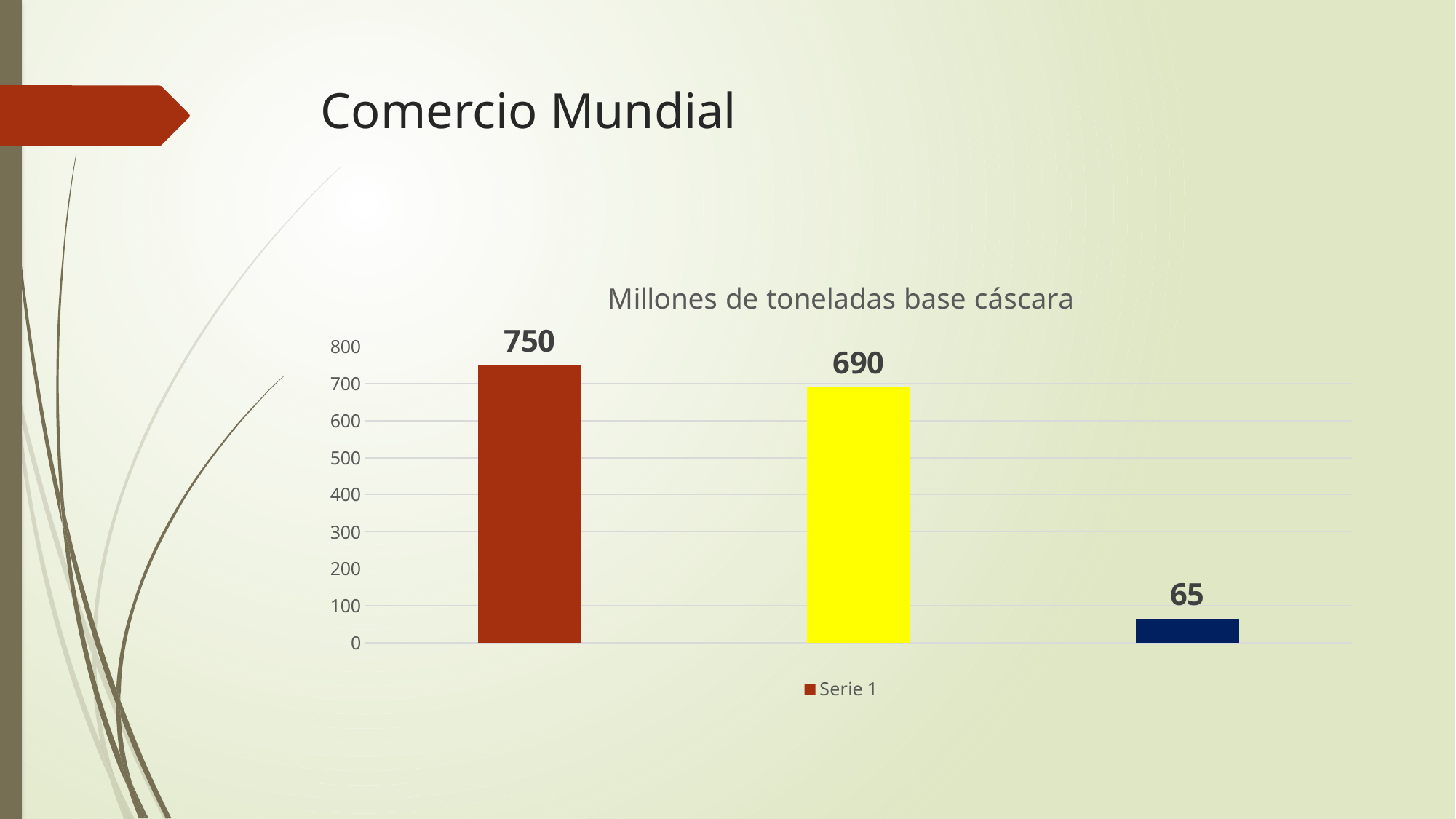
What is the title of the chart? Millones de toneladas base cáscara What is the difference between the red bar and the yellow bar? 60 How many series does the legend list? 1 What is the value of the red bar (first bar) in the chart? 750 What is the difference between the yellow bar and the dark blue bar? 625 Which bar has the lowest value in the chart? The dark blue bar (third bar), 65 Which bar has the highest value in the chart? The red bar (first bar), 750 How many bars are plotted in the chart? 3 Which is larger, the red bar or the yellow bar? The red bar What is the value of the yellow bar (second bar) in the chart? 690 What kind of chart is shown on the slide? Bar chart What is the value of the dark blue bar (third bar) in the chart? 65